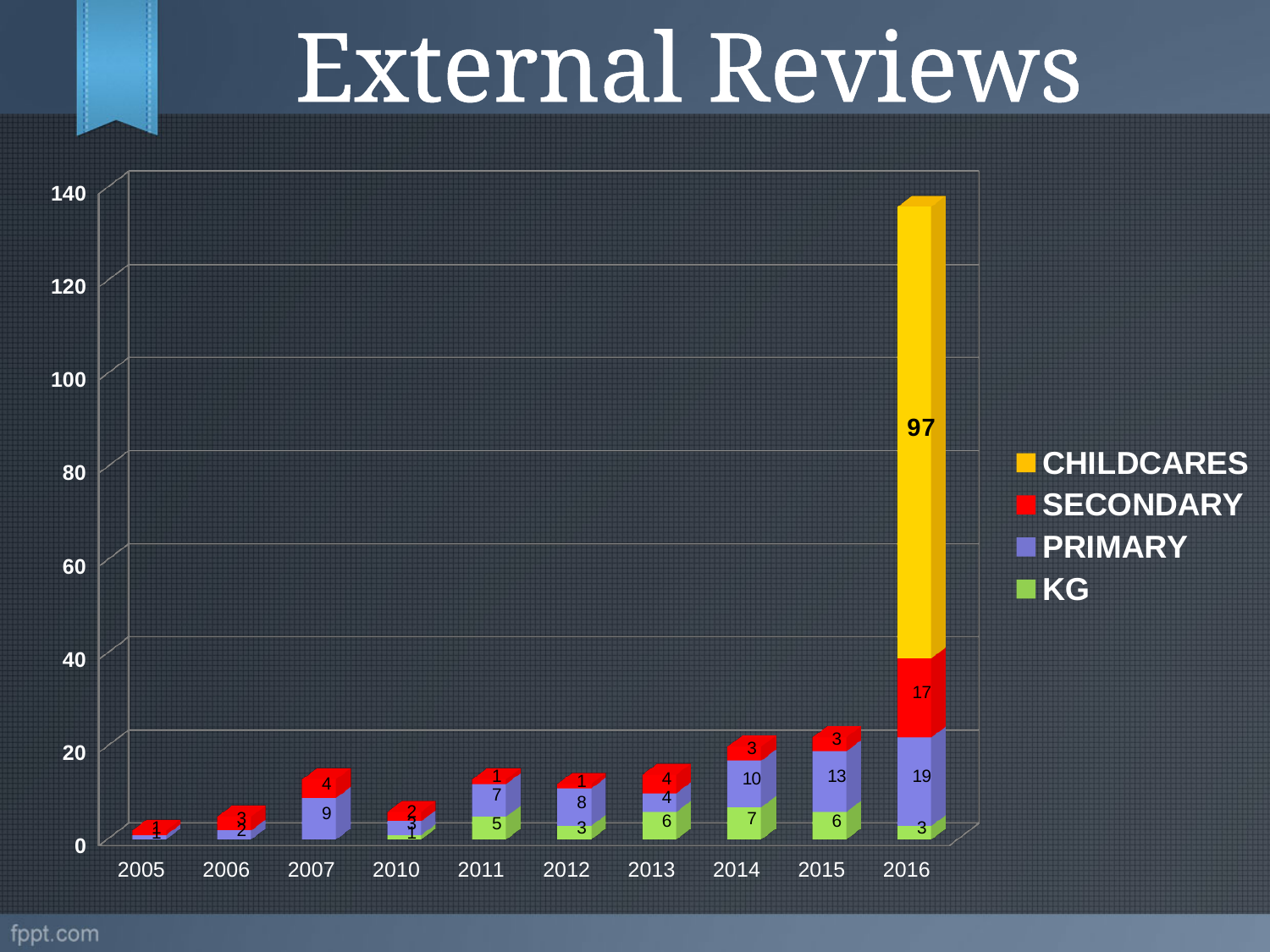
What is the total of the stacked bar for 2016? 136 What is the value for KG in 2014? 7 How many series does the legend list? 4 In 2014, which is larger: PRIMARY or KG? PRIMARY How many years are shown on the x axis? 10 Which year has the tallest stacked bar? 2016 What is the total of the stacked bar for 2014? 20 What is the value for PRIMARY in 2015? 13 What kind of chart is shown on the slide? Stacked bar chart What is the value for CHILDCARES in 2016? 97 What is the difference between the PRIMARY values for 2016 and 2015? 6 What is the value for SECONDARY in 2016? 17